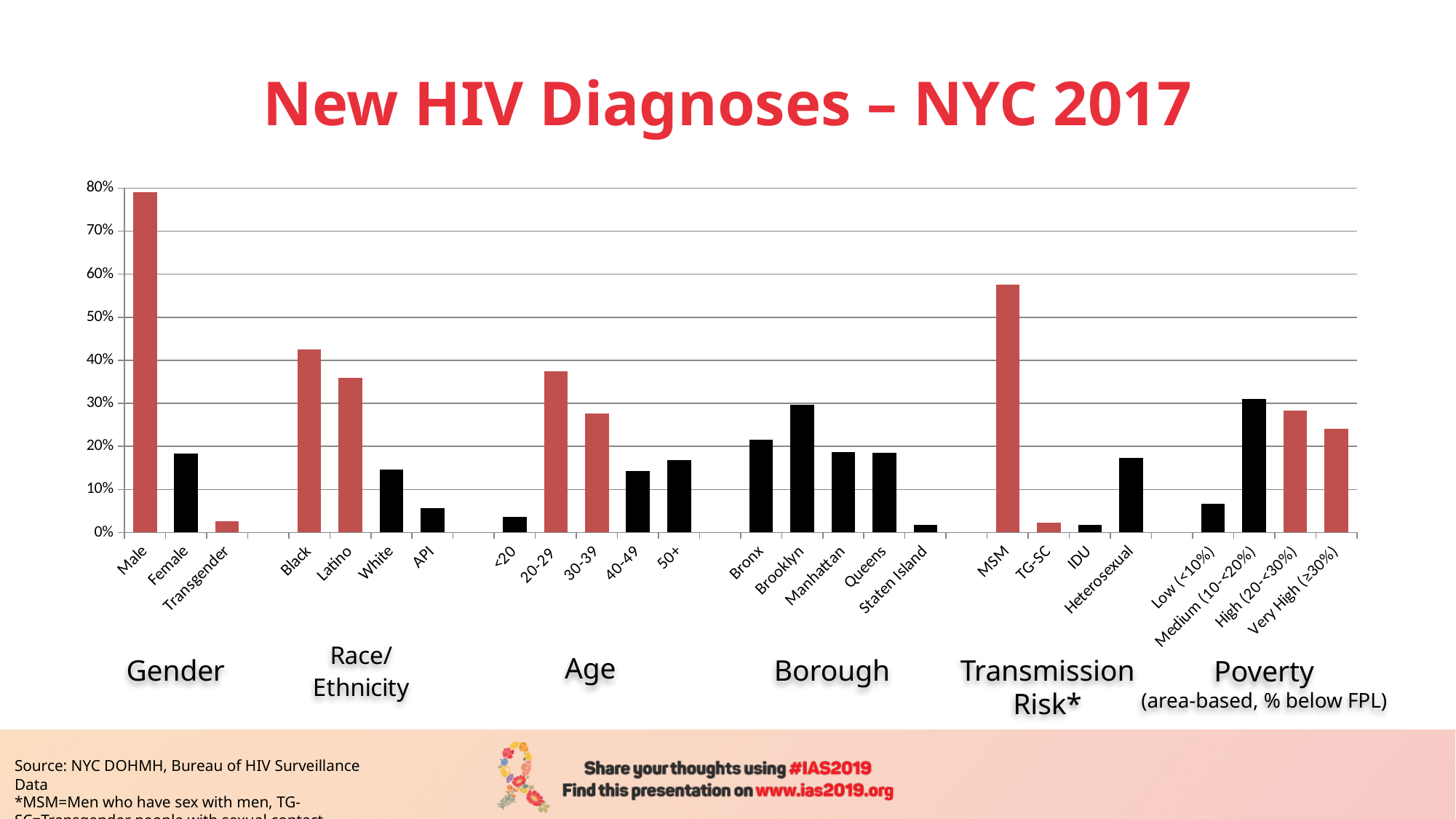
Which category has the highest bar in the whole chart? Male Within the Borough group, which borough has the lowest bar? Staten Island Is the value for Male greater or less than 70%? greater What kind of chart is shown on the slide? bar chart Which is larger, the value for 20-29 or the value for 30-39? 20-29 Which is larger, the value for Black or the value for Latino? Black Is the value for Very High (≥30%) poverty greater or less than 30%? less How many age categories are shown in the Age group? 5 Within the Borough group, which borough has the highest bar? Brooklyn What is the title of the chart? New HIV Diagnoses – NYC 2017 Is the value for Female greater or less than 20%? less